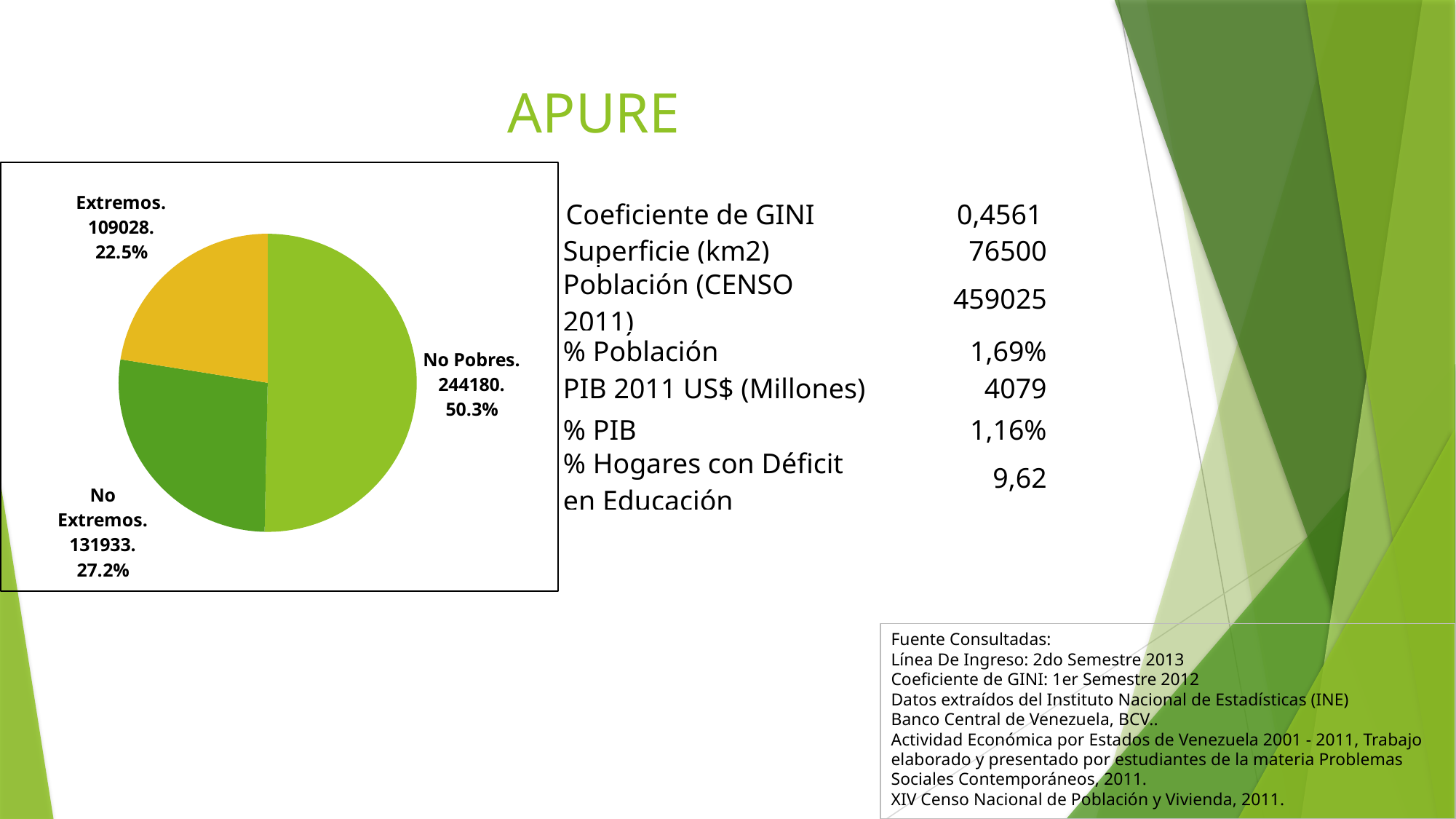
Which is larger, the No Extremos slice or the Extremos slice? No Extremos What kind of chart is shown on the slide? pie chart What share of the pie does the No Extremos slice represent? 27.2% What is the value shown for the Extremos slice? 109028 Which slice of the pie chart is the largest? No Pobres What is the value shown for the No Pobres slice? 244180 What is the difference between the No Extremos value and the Extremos value? 22905 What share of the pie does the Extremos slice represent? 22.5% What is the value shown for the No Extremos slice? 131933 What share of the pie does the No Pobres slice represent? 50.3% How many slices does the pie chart have? 3 Which slice of the pie chart is the smallest? Extremos